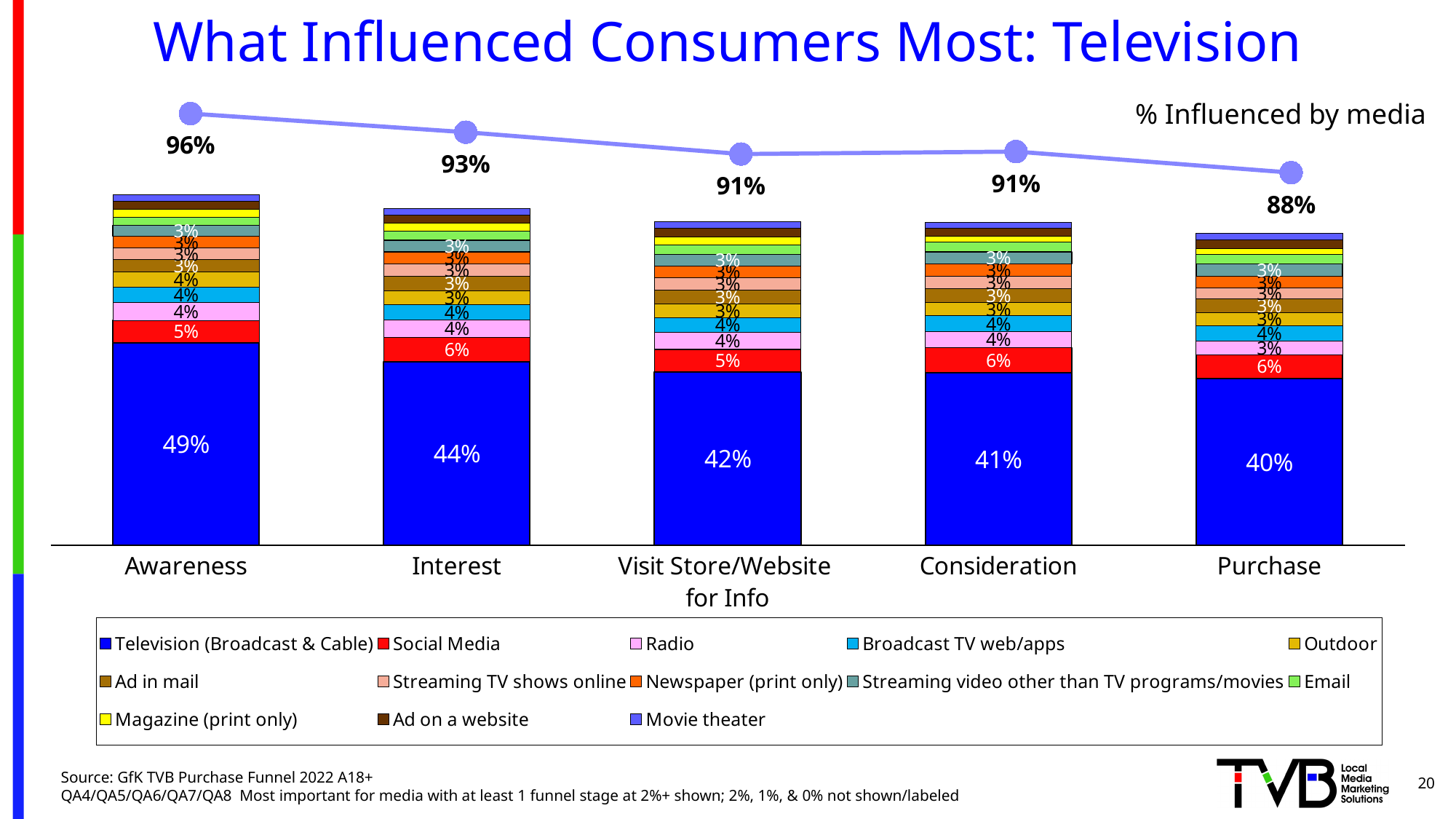
At which funnel stage is the Television (Broadcast & Cable) share lowest? Purchase How does the '% Influenced by media' line change from Awareness to Purchase? It falls At which funnel stage is the Television (Broadcast & Cable) share highest? Awareness Which stage has the larger Social Media share, Awareness or Interest? Interest How many media series does the legend list? 13 What is the Television (Broadcast & Cable) value for the Purchase stage? 40% What is the Social Media value for the Interest stage? 6% What is the '% Influenced by media' value for the Purchase stage? 88% How many percentage points higher is the Television share at Awareness than at Purchase? 9 percentage points How many funnel stages are shown on the x axis? 5 What is the '% Influenced by media' value shown above the Awareness bar? 96% What percentage of consumers at the Awareness stage were most influenced by Television (Broadcast & Cable)? 49%